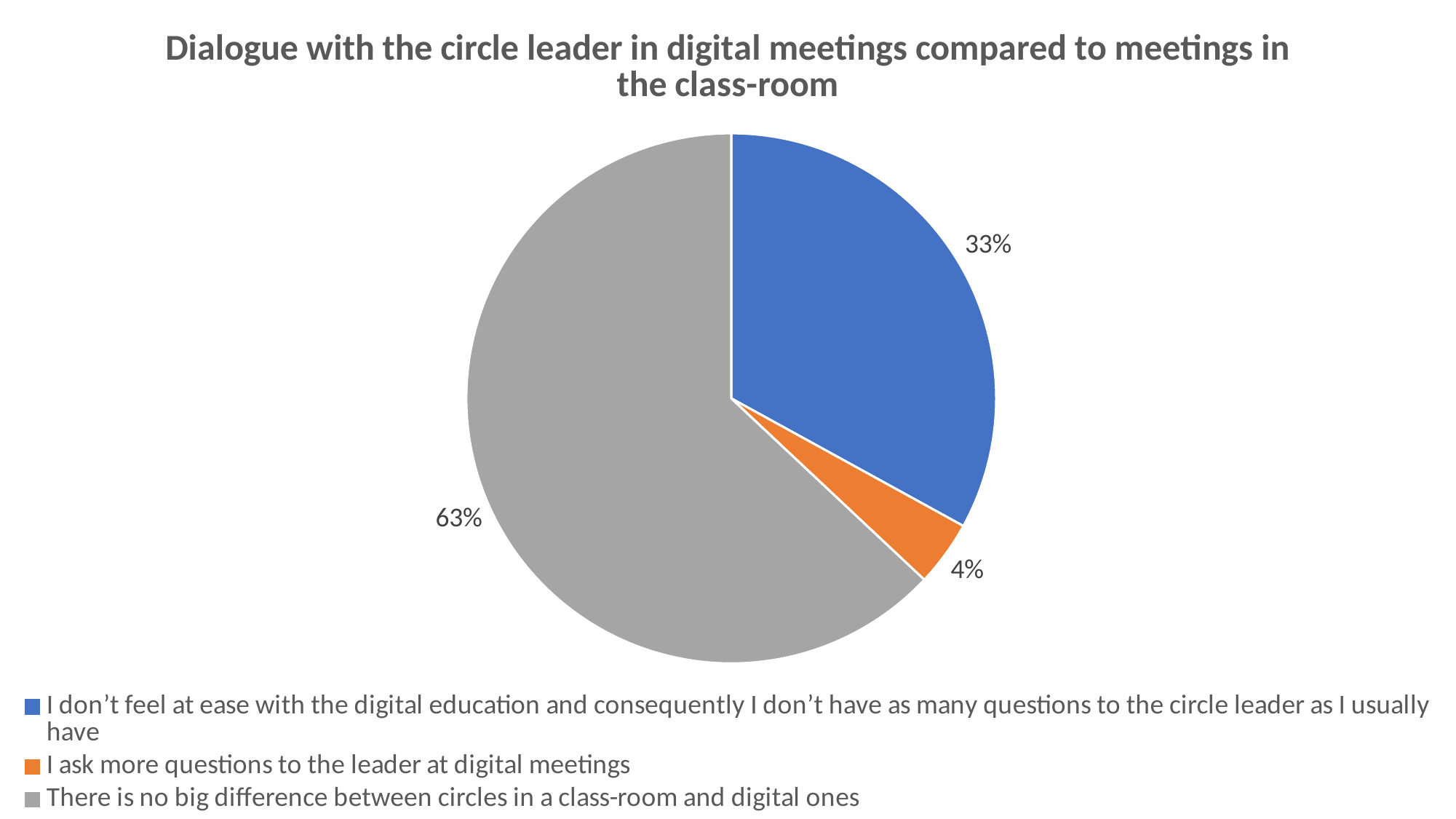
How many categories does the pie chart have? 3 Which category has the largest slice of the pie? There is no big difference between circles in a class-room and digital ones What is the title of the chart? Dialogue with the circle leader in digital meetings compared to meetings in the class-room What kind of chart is shown on the slide? pie chart Which category has the smallest slice of the pie? I ask more questions to the leader at digital meetings What share of the pie is 'There is no big difference between circles in a class-room and digital ones'? 63% What is the value for 'I don't feel at ease with the digital education and consequently I don't have as many questions to the circle leader as I usually have'? 33% What colour is the slice for 'I ask more questions to the leader at digital meetings'? orange What is the difference between the 'There is no big difference' slice and the 'I don't feel at ease with the digital education' slice? 30% What is the difference between the 'I don't feel at ease with the digital education' slice and the 'I ask more questions to the leader at digital meetings' slice? 29% Which is larger: the 'I don't feel at ease with the digital education' slice or the 'I ask more questions to the leader at digital meetings' slice? I don't feel at ease with the digital education and consequently I don't have as many questions to the circle leader as I usually have What share of the pie is 'I ask more questions to the leader at digital meetings'? 4%